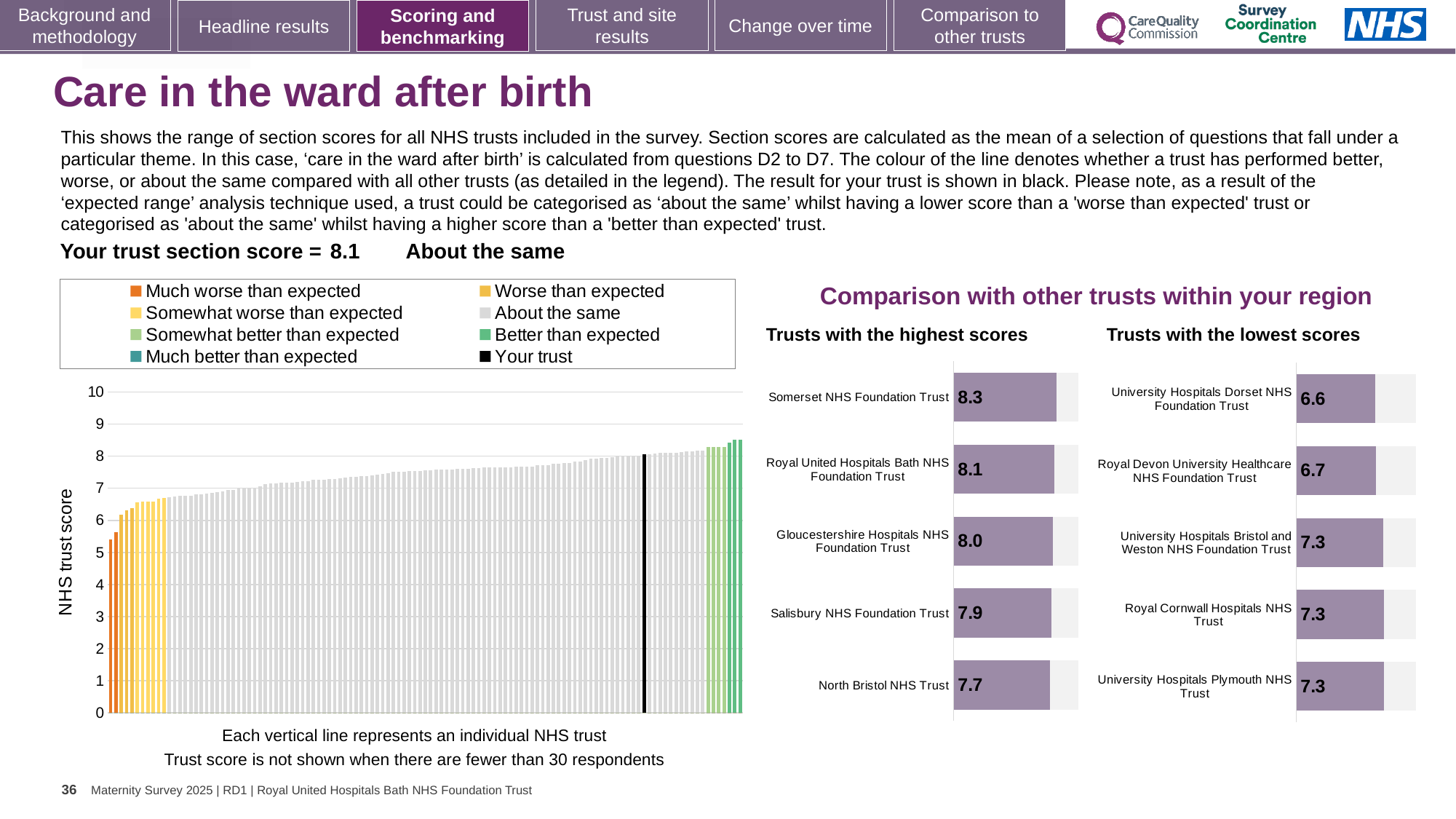
In the 'Trusts with the lowest scores' chart, what is the difference between the scores of Royal Cornwall Hospitals NHS Trust and University Hospitals Dorset NHS Foundation Trust? 0.7 How many entries does the legend above the large 'NHS trust score' chart list? 8 How many trusts are shown in the 'Trusts with the highest scores' chart? 5 In the 'Trusts with the highest scores' chart, what is the score for Somerset NHS Foundation Trust? 8.3 In the large 'NHS trust score' chart on the left, do the values rise or fall from left to right? Rise In the 'Trusts with the lowest scores' chart, which has the larger score: University Hospitals Dorset NHS Foundation Trust or Royal Devon University Healthcare NHS Foundation Trust? Royal Devon University Healthcare NHS Foundation Trust In the 'Trusts with the highest scores' chart, what is the score for North Bristol NHS Trust? 7.7 In the 'Trusts with the highest scores' chart, what is the difference between the scores of Somerset NHS Foundation Trust and North Bristol NHS Trust? 0.6 What kind of chart is the large chart on the left with the y-axis labelled 'NHS trust score'? Bar chart In the 'Trusts with the lowest scores' chart, which trust has the lowest score? University Hospitals Dorset NHS Foundation Trust In the 'Trusts with the highest scores' chart, which trust has the highest score? Somerset NHS Foundation Trust In the 'Trusts with the lowest scores' chart, what is the score for University Hospitals Dorset NHS Foundation Trust? 6.6